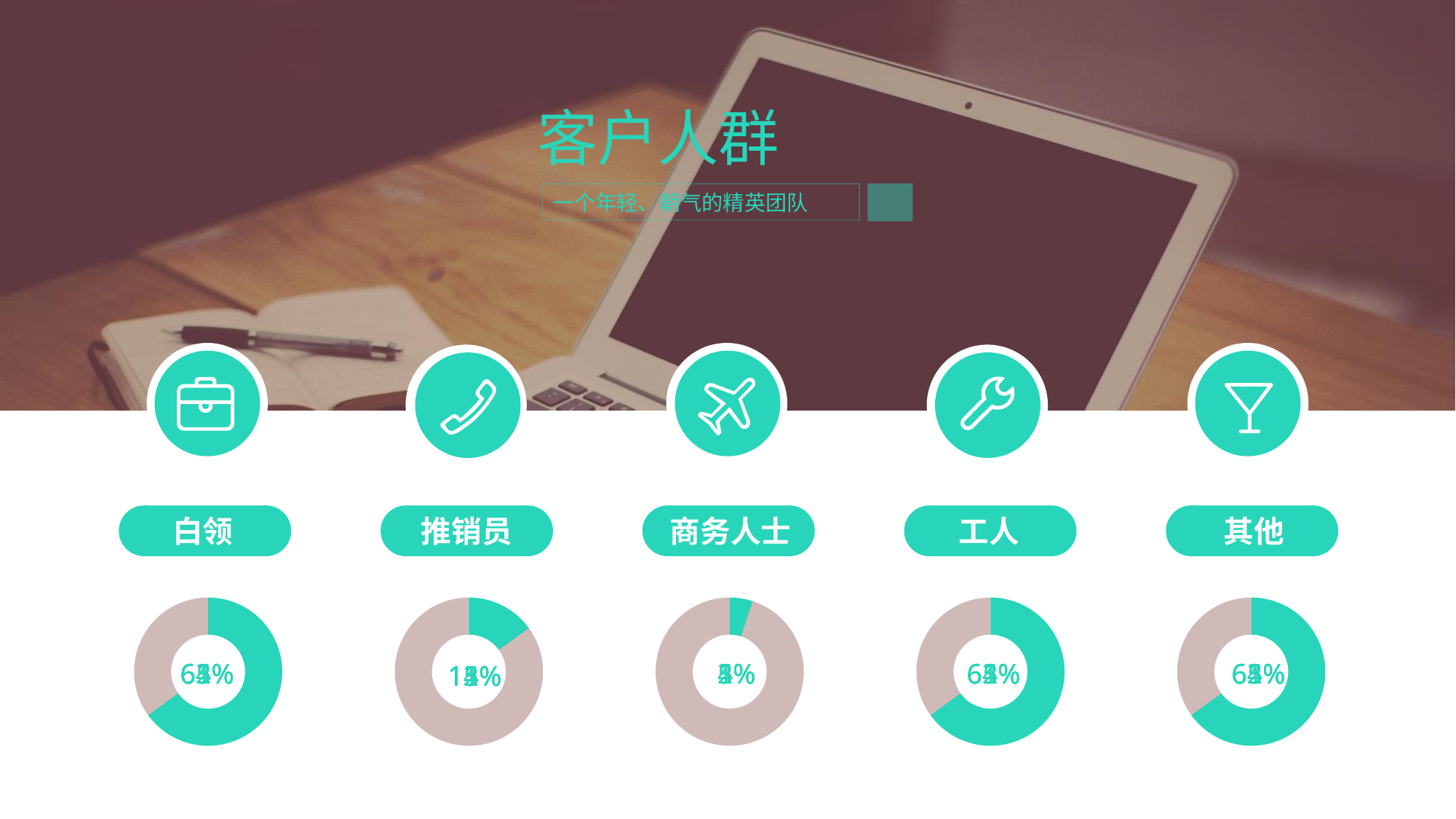
Comparing the 工人 and 商务人士 donut charts, which has the larger teal share? 工人 Which customer group's donut chart has the smallest teal share? 商务人士 What kind of chart is used under each customer group label on the slide? Donut (pie) chart What is the main title of the slide containing the donut charts? 客户人群 Comparing the 白领 and 推销员 donut charts, which has the larger teal share? 白领 Comparing the 其他 and 推销员 donut charts, which has the larger teal share? 其他 How many donut charts are shown on the slide? 5 How many slices does each donut chart on the slide contain? 2 What is the label of the customer group above the third donut chart from the left? 商务人士